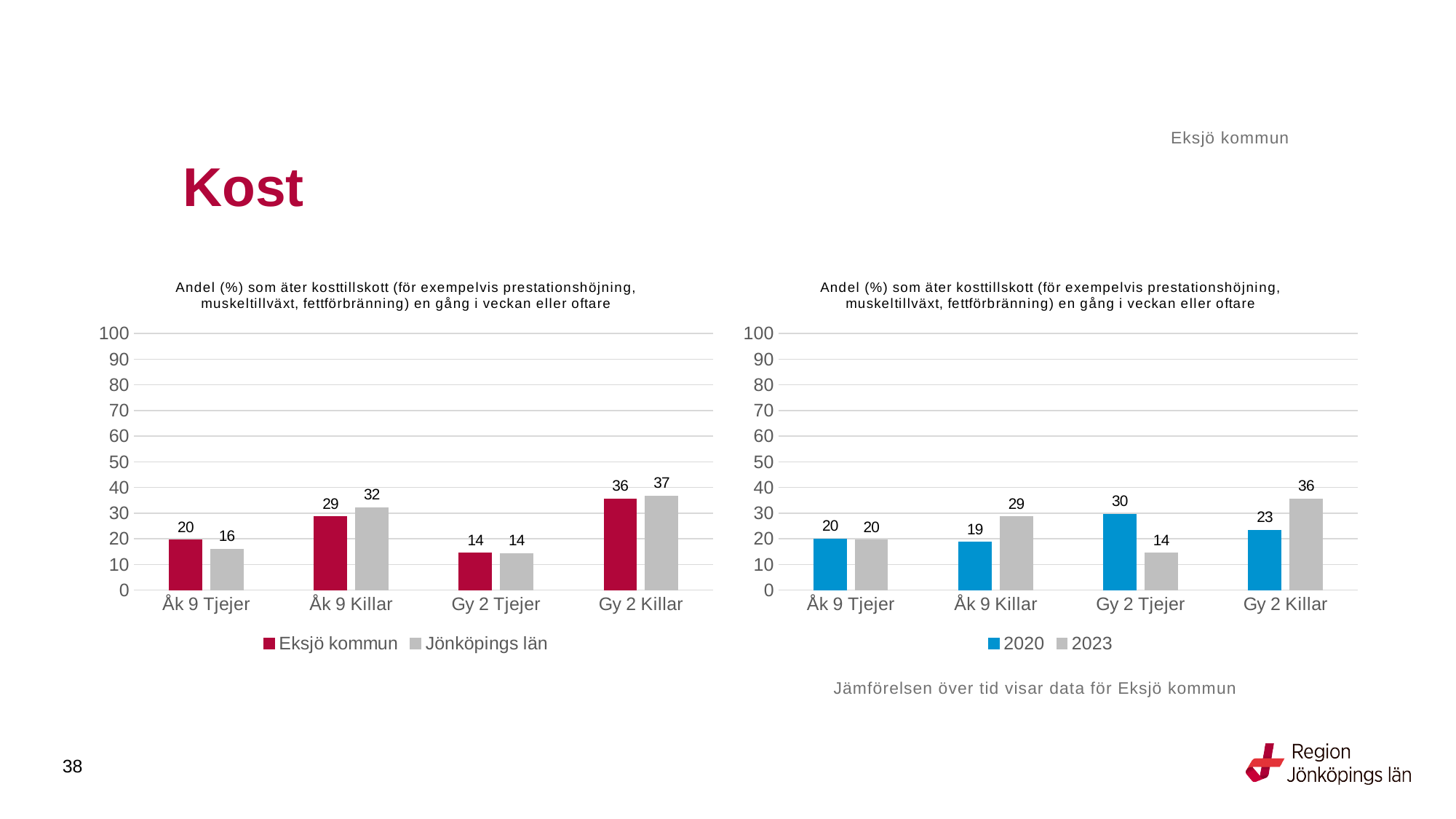
In the left chart (Eksjö kommun vs Jönköpings län), what is the difference between Eksjö kommun and Jönköpings län for Åk 9 Tjejer? 4 In the right chart (2020 vs 2023), how many categories are shown on the x axis? 4 What kind of chart is the right chart (2020 vs 2023)? Bar chart In the right chart (2020 vs 2023), what is the value for 2020 for Gy 2 Tjejer? 30 In the left chart (Eksjö kommun vs Jönköpings län), what is the value for Eksjö kommun for Åk 9 Killar? 29 In the right chart (2020 vs 2023), what is the difference between 2020 and 2023 for Gy 2 Tjejer? 16 In the left chart (Eksjö kommun vs Jönköpings län), how many series does the legend list? 2 In the right chart (2020 vs 2023), which is larger for Åk 9 Killar, 2020 or 2023? 2023 In the right chart (2020 vs 2023), what is the value for 2023 for Gy 2 Killar? 36 In the left chart (Eksjö kommun vs Jönköpings län), which category has the lowest value for Jönköpings län? Gy 2 Tjejer In the left chart (Eksjö kommun vs Jönköpings län), what is the value for Jönköpings län for Gy 2 Killar? 37 In the left chart (Eksjö kommun vs Jönköpings län), which category has the highest value for Eksjö kommun? Gy 2 Killar